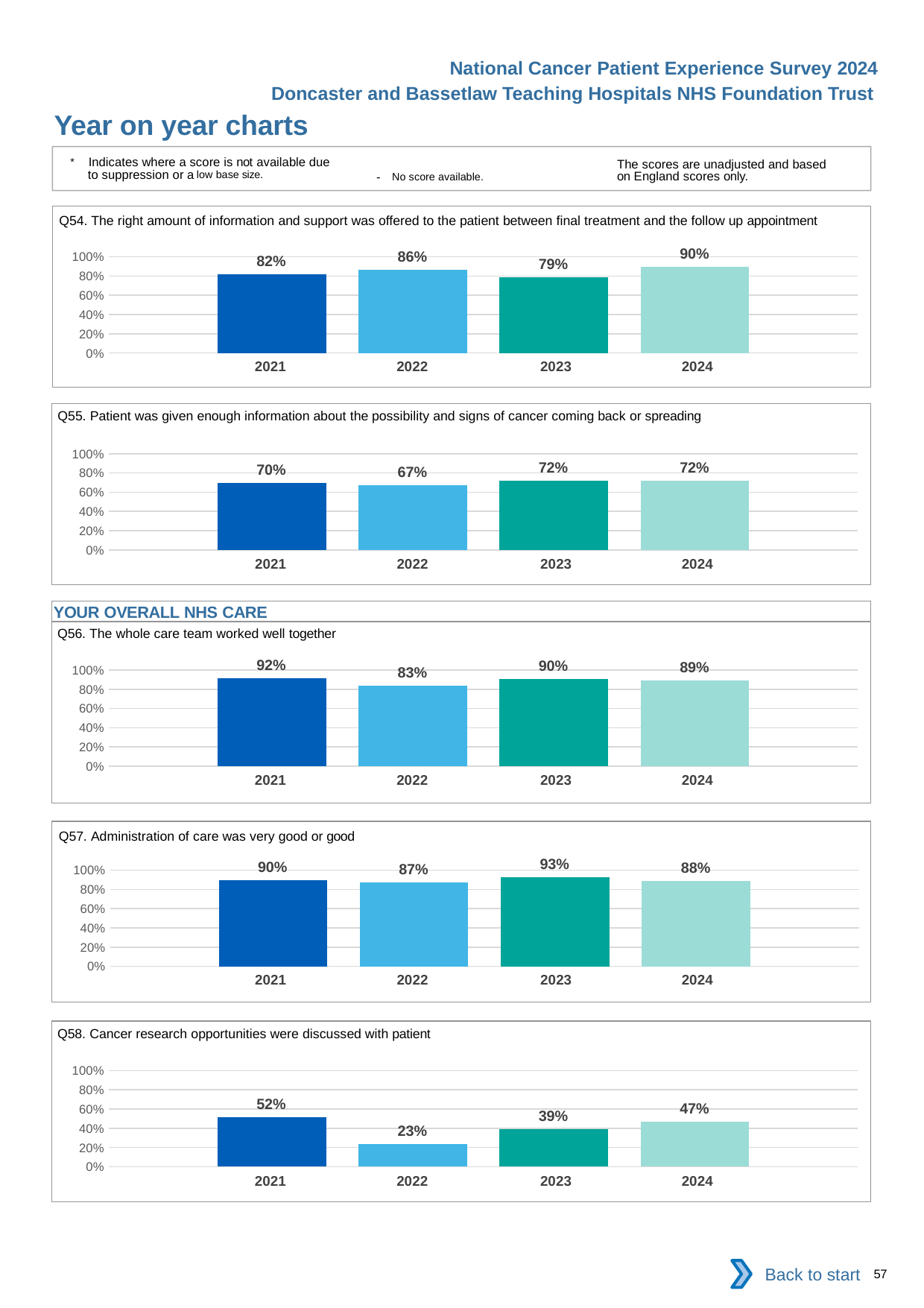
In the Q55 chart, what is the value for 2022? 67% In the Q57 chart, what is the difference between the 2021 and 2024 values? 2% What type of chart is used for Q54? bar chart In the Q57 chart, what is the value for 2023? 93% In the Q54 chart, what is the value for 2024? 90% In the Q58 chart, which year has the lowest value? 2022 In the Q56 chart, is the value for 2022 larger or smaller than the value for 2024? smaller In the Q54 chart, which year has the lowest value? 2023 How many bars are plotted in the Q58 chart? 4 In the Q56 chart, which year has the highest value? 2021 In the Q55 chart, what is the difference between the 2023 and 2022 values? 5% In the Q58 chart, what is the difference between the 2021 and 2022 values? 29%